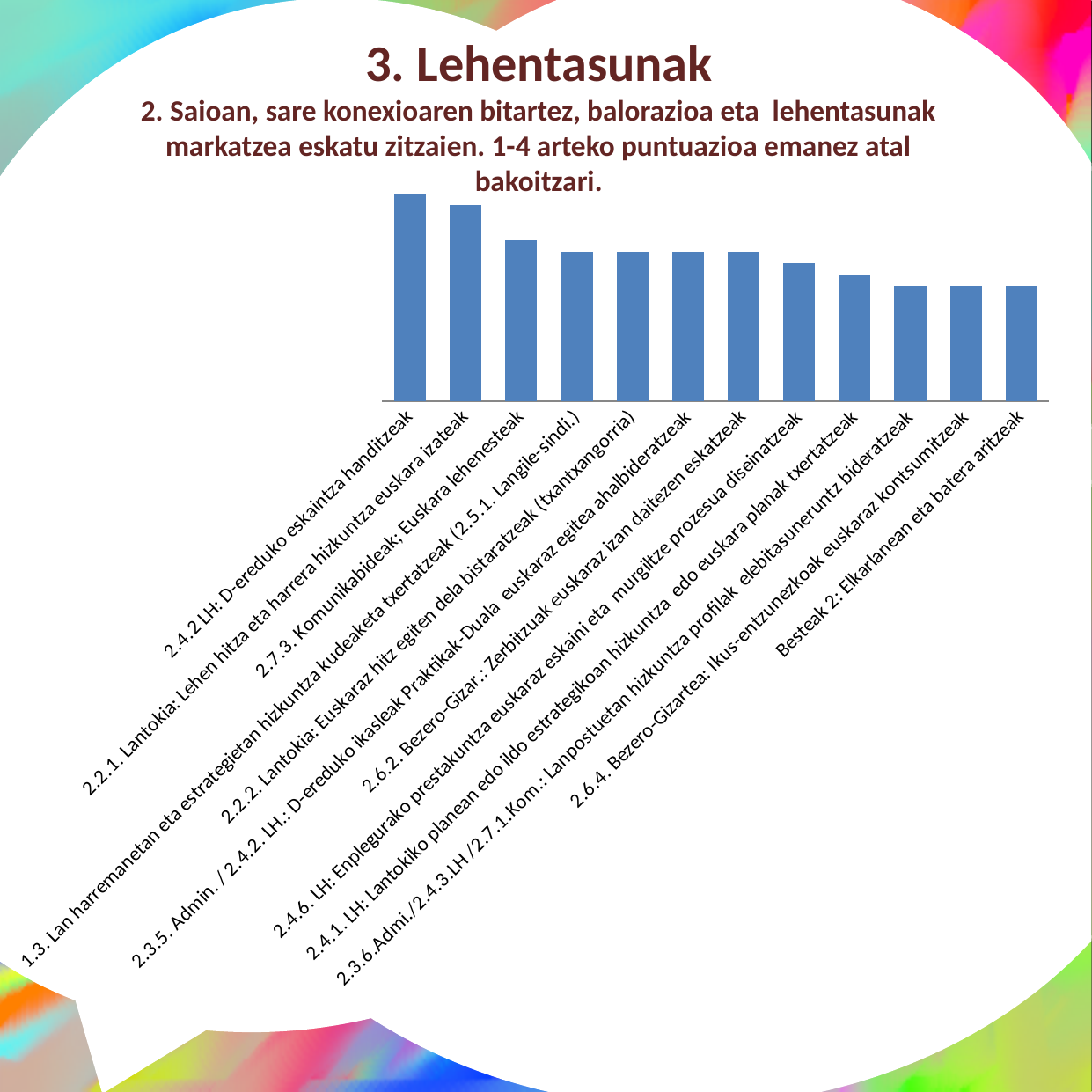
Which bar is taller: '2.7.3. Komunikabideak; Euskara lehenesteak' or '2.4.1. LH: Lantokiko planean edo ildo estrategikoan hizkuntza edo euskara planak txertatzeak'? 2.7.3. Komunikabideak; Euskara lehenesteak Which bar is taller: '2.4.6. LH: Enplegurako prestakuntza euskaraz eskaini eta murgiltze prozesua diseinatzeak' or '2.2.1. Lantokia: Lehen hitza eta harrera hizkuntza euskara izateak'? 2.2.1. Lantokia: Lehen hitza eta harrera hizkuntza euskara izateak What colour are the bars in the chart? blue How many data series are plotted in the chart? 1 Which bar is taller: '2.2.1. Lantokia: Lehen hitza eta harrera hizkuntza euskara izateak' or '2.6.4. Bezero-Gizartea: Ikus-entzunezkoak euskaraz kontsumitzeak'? 2.2.1. Lantokia: Lehen hitza eta harrera hizkuntza euskara izateak What kind of chart is shown on the slide? bar chart Which category has the highest bar in the chart? 2.4.2 LH: D-ereduko eskaintza handitzeak How many bars (categories) does the chart show? 12 Which category is plotted as the first (leftmost) bar? 2.4.2 LH: D-ereduko eskaintza handitzeak Do the bar heights generally rise or fall from left to right across the chart? fall